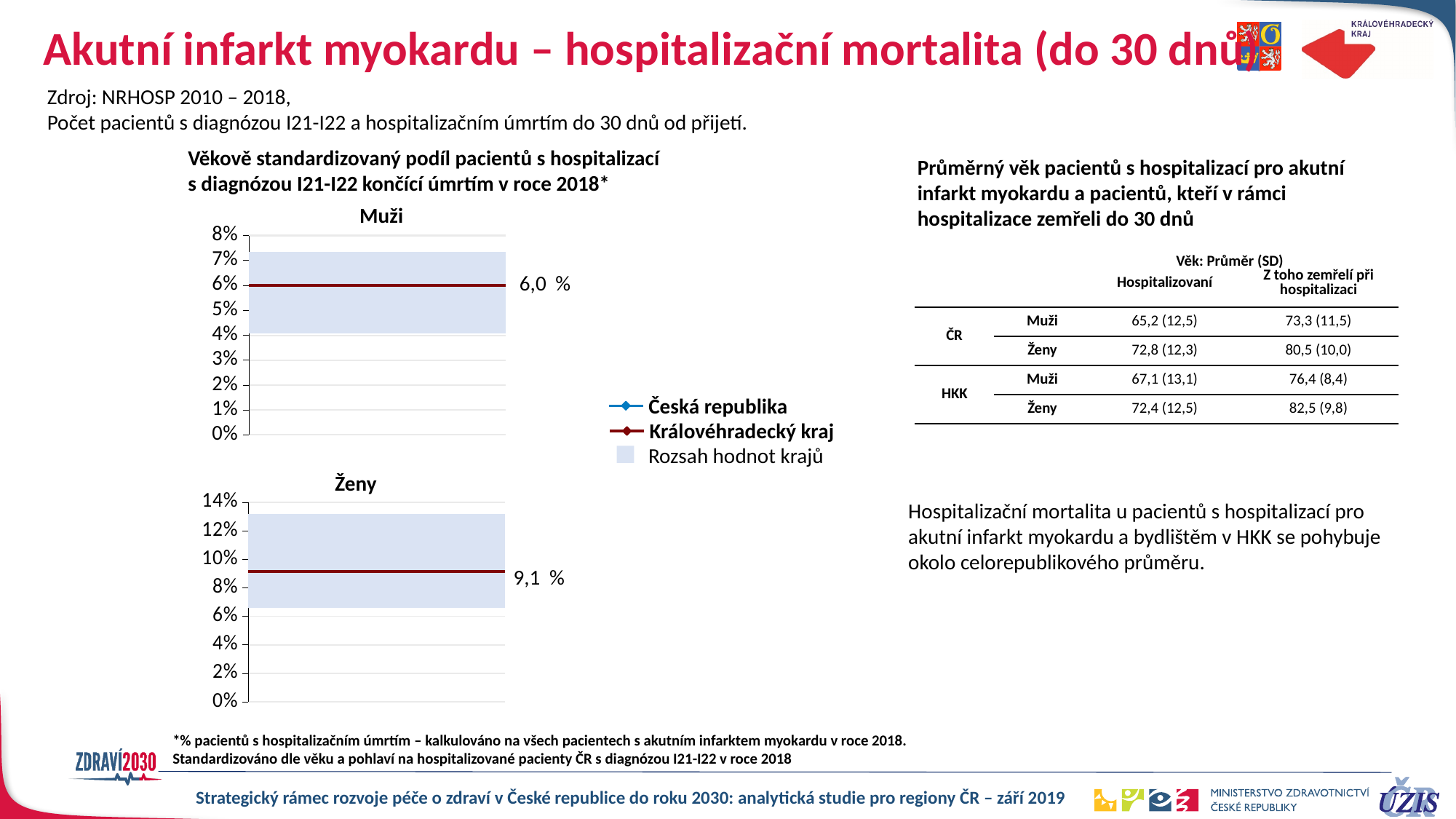
What is the highest tick on the y axis of the Ženy chart? 14% How many entries does the shared legend of the two charts list? 3 In the Muži chart, is the Královéhradecký kraj value greater or less than 5%? greater In the Ženy chart, is the Královéhradecký kraj value greater or less than 10%? less What is the highest tick on the y axis of the Muži chart? 8% In the Ženy chart, what value is labelled for Královéhradecký kraj? 9,1 % Comparing the labelled Královéhradecký kraj values, is the Muži chart or the Ženy chart higher? Ženy What is the difference between the labelled Královéhradecký kraj values in the Ženy chart and the Muži chart? 3,1 % In the Muži chart, what value is labelled for Královéhradecký kraj? 6,0 % What kind of chart is the Muži chart? combination area and line chart In the Ženy chart, is the lower edge of the shaded regional range (Rozsah hodnot krajů) greater or less than 6%? greater